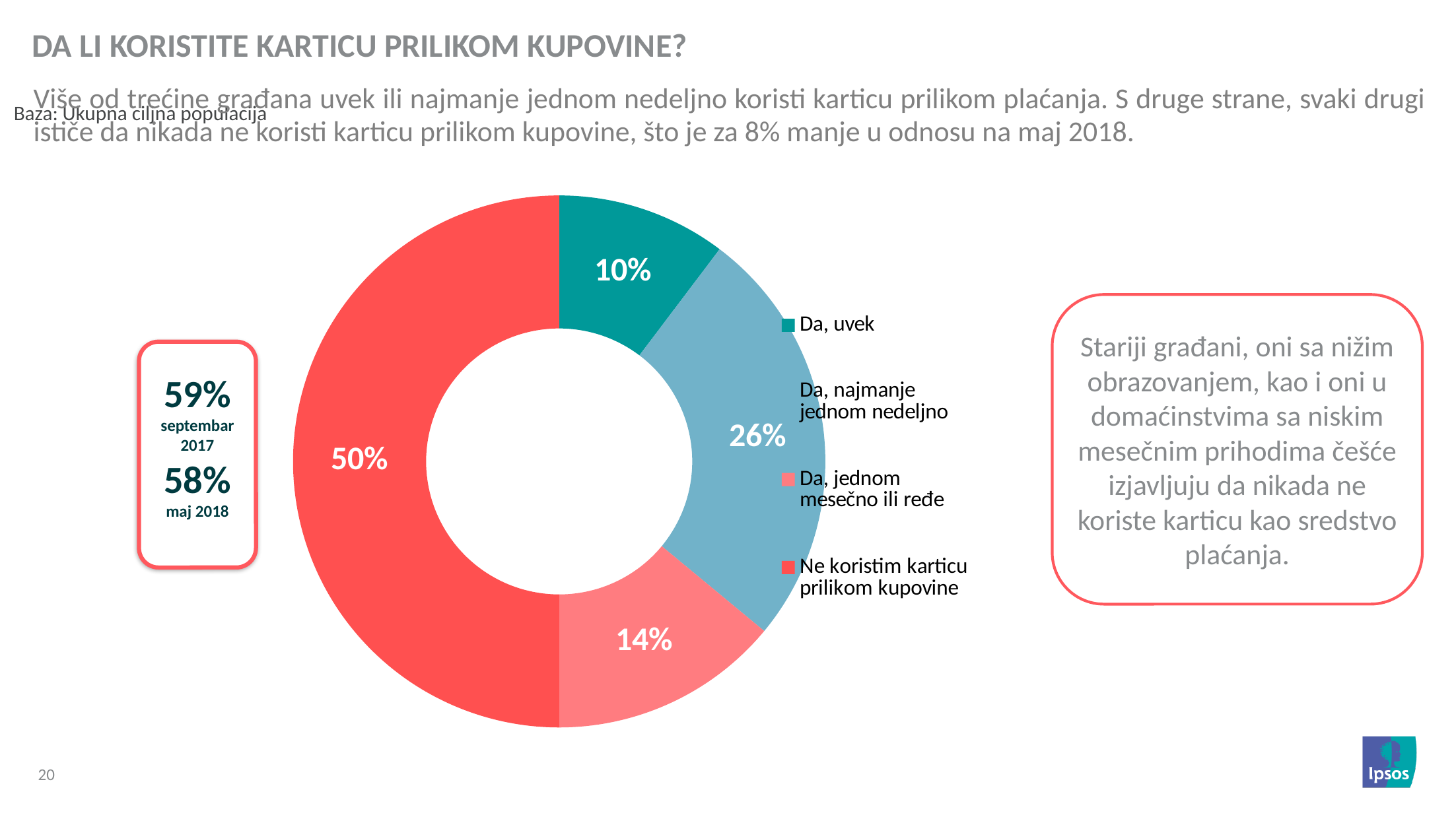
What is the title of the slide containing the chart? DA LI KORISTITE KARTICU PRILIKOM KUPOVINE? What share of the pie is labelled "Da, najmanje jednom nedeljno"? 26% What is the difference in percentage points between "Da, najmanje jednom nedeljno" and "Da, jednom mesečno ili ređe"? 12 What share of the pie is labelled "Da, uvek"? 10% What share of the pie is labelled "Ne koristim karticu prilikom kupovine"? 50% What kind of chart is shown on the slide? Doughnut chart Which is larger: the slice for "Da, najmanje jednom nedeljno" or the slice for "Da, uvek"? Da, najmanje jednom nedeljno Which category has the smallest slice of the pie? Da, uvek What share of the pie is labelled "Da, jednom mesečno ili ređe"? 14% How many categories does the pie chart show? 4 Which category has the largest slice of the pie? Ne koristim karticu prilikom kupovine What colour is the slice for "Ne koristim karticu prilikom kupovine"? Red